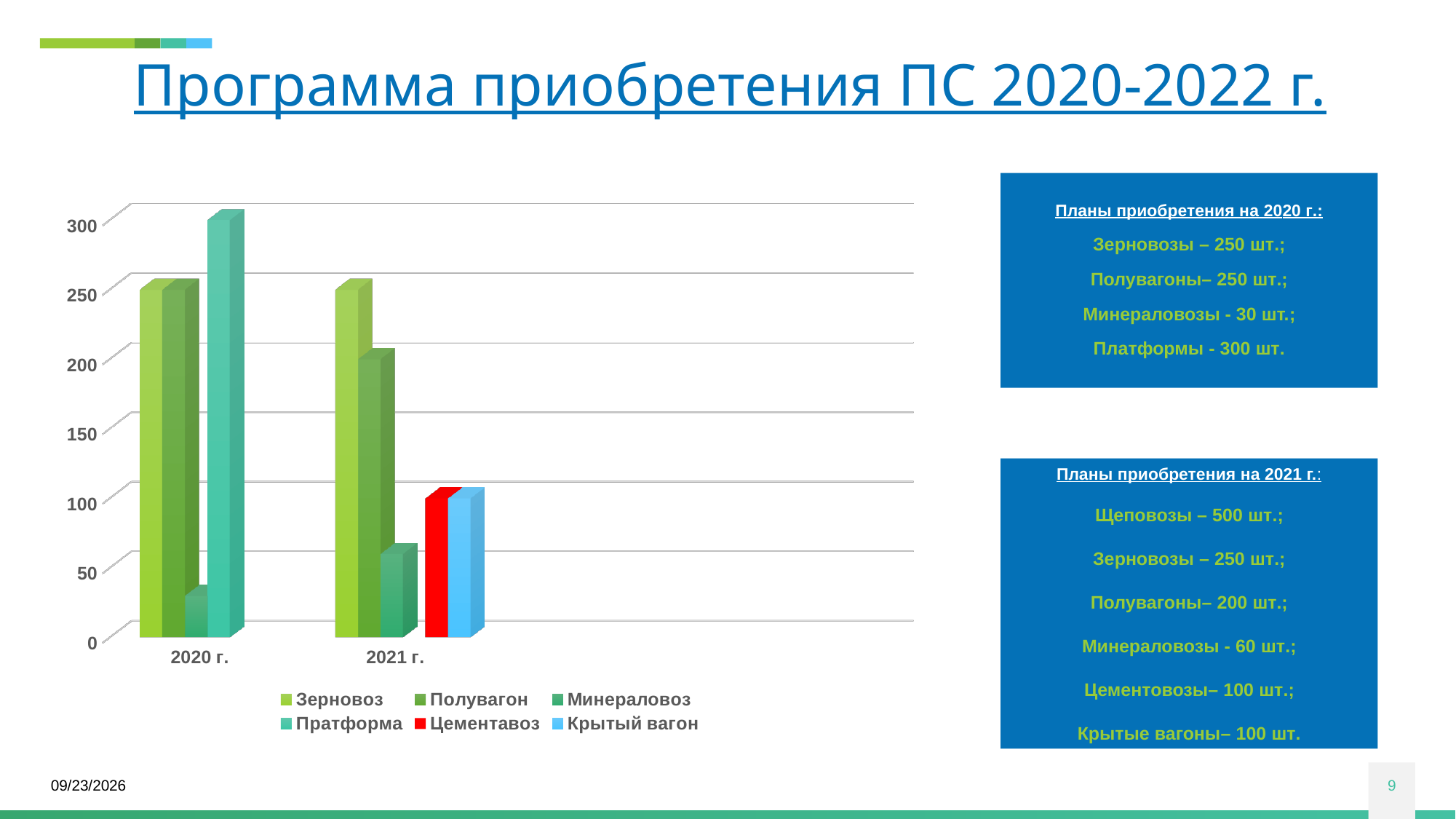
How many series does the chart legend list? 6 How many year categories are shown on the x axis of the chart? 2 Is the value for Минераловоз in 2020 г. greater or less than 50? less What kind of chart is shown on the slide? bar chart Which series has the highest value in 2020 г.? Пратформа What colour represents Цементавоз in the chart legend? red What is the value for Полувагон in 2021 г.? 200 What is the value for Зерновоз in 2020 г.? 250 Is the value for Полувагон larger in 2020 г. or in 2021 г.? 2020 г. What is the value for Пратформа in 2020 г.? 300 What is the value for Цементавоз in 2021 г.? 100 Which series has the lowest value in 2020 г.? Минераловоз